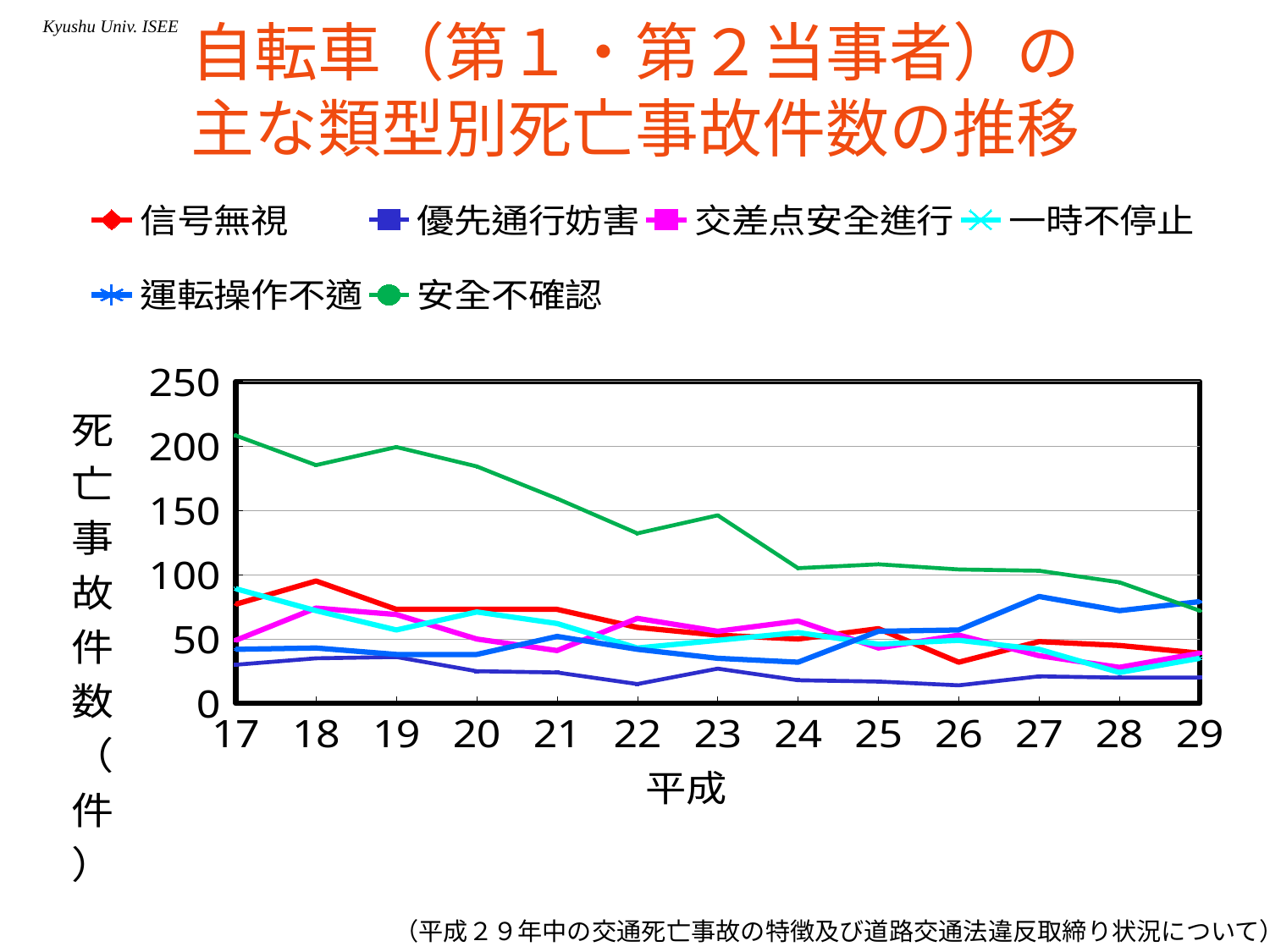
How many years (points) are shown along the x axis? 13 How many series does the legend list? 6 In 平成17, which is larger: the value for 安全不確認 or the value for 信号無視? 安全不確認 Is the value for 安全不確認 in 平成29 greater or less than 100? less What kind of chart is shown on the slide? line chart Does the 安全不確認 series generally rise or fall from 平成17 to 平成29? fall Is the value for 優先通行妨害 in 平成29 greater or less than 50? less What is the label of the x axis? 平成 Which series has the highest value in 平成17? 安全不確認 Is the value for 安全不確認 in 平成17 greater or less than 200? greater Which series has the lowest value in 平成29? 優先通行妨害